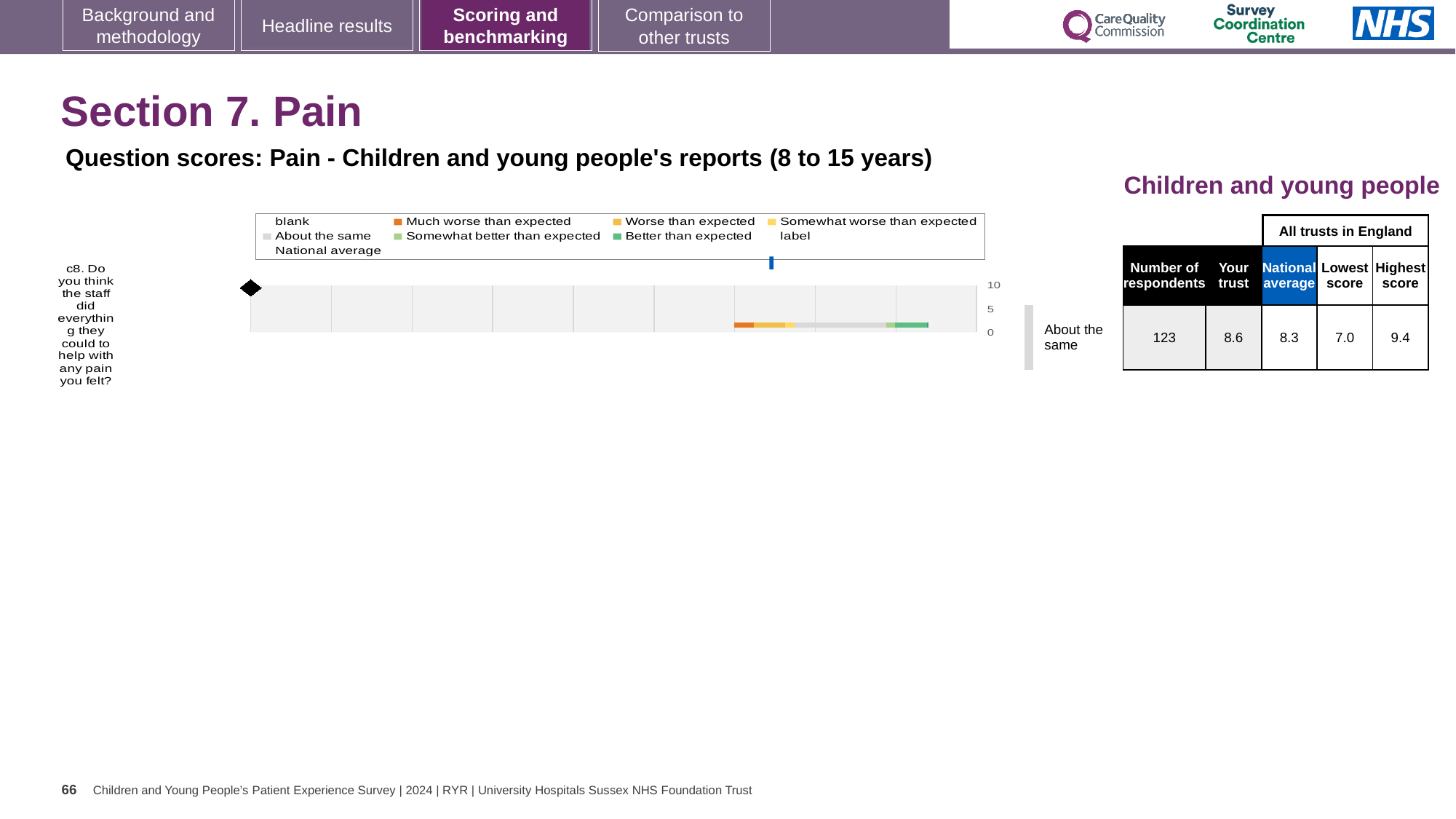
What is the highest value shown on the chart's axis? 10 In the table beside the chart, how many respondents answered question c8? 123 In the table beside the chart, what is the Lowest score across all trusts in England for question c8? 7.0 What benchmark category is shown next to the chart for question c8? About the same In the table beside the chart, what is the 'Your trust' score for question c8? 8.6 What is the difference between the Highest score and the Lowest score for question c8 in the table? 2.4 What kind of chart is shown on the slide? bar chart In the table beside the chart, what is the Highest score across all trusts in England for question c8? 9.4 In the table beside the chart, what is the National average score for question c8? 8.3 Which is larger for question c8, the 'Your trust' score or the National average? Your trust How many survey questions are plotted in the chart? 1 What is the question label shown on the left of the chart? c8. Do you think the staff did everything they could to help with any pain you felt?